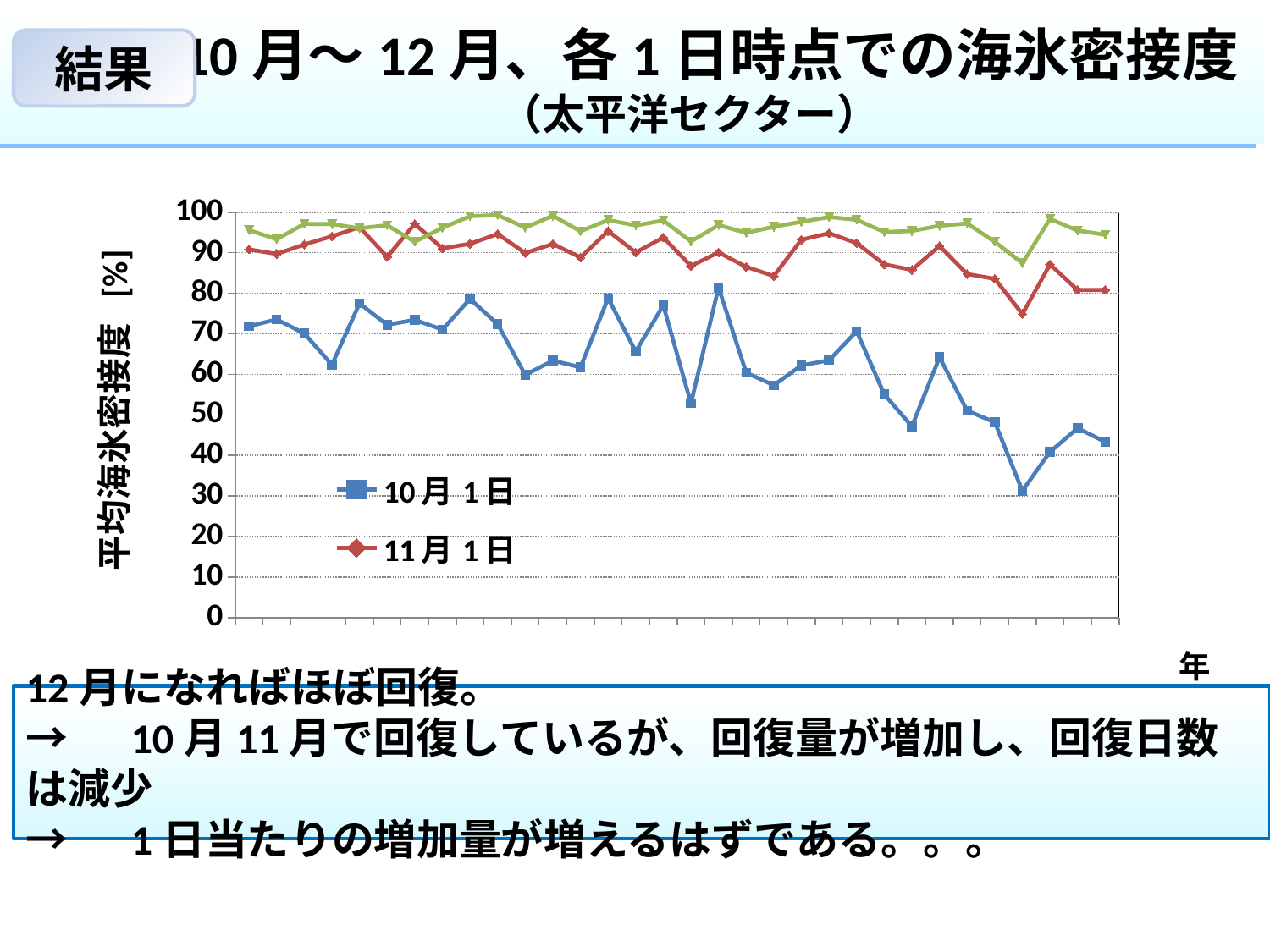
Is the first (leftmost) value of the 10月1日 series greater or less than 60? greater Is the lowest value of the 10月1日 series greater or less than 40? less What kind of chart is shown on the slide? line chart What is the label of the vertical axis of the chart? 平均海氷密接度 [%] How many series does the chart's legend list? 2 Which series has higher values overall, 10月1日 or 11月1日? 11月1日 Is the last (rightmost) value of the 10月1日 series greater or less than 50? less Does the 10月1日 series generally rise or fall from left to right along the x axis? fall What colour is the line for the 10月1日 series? blue